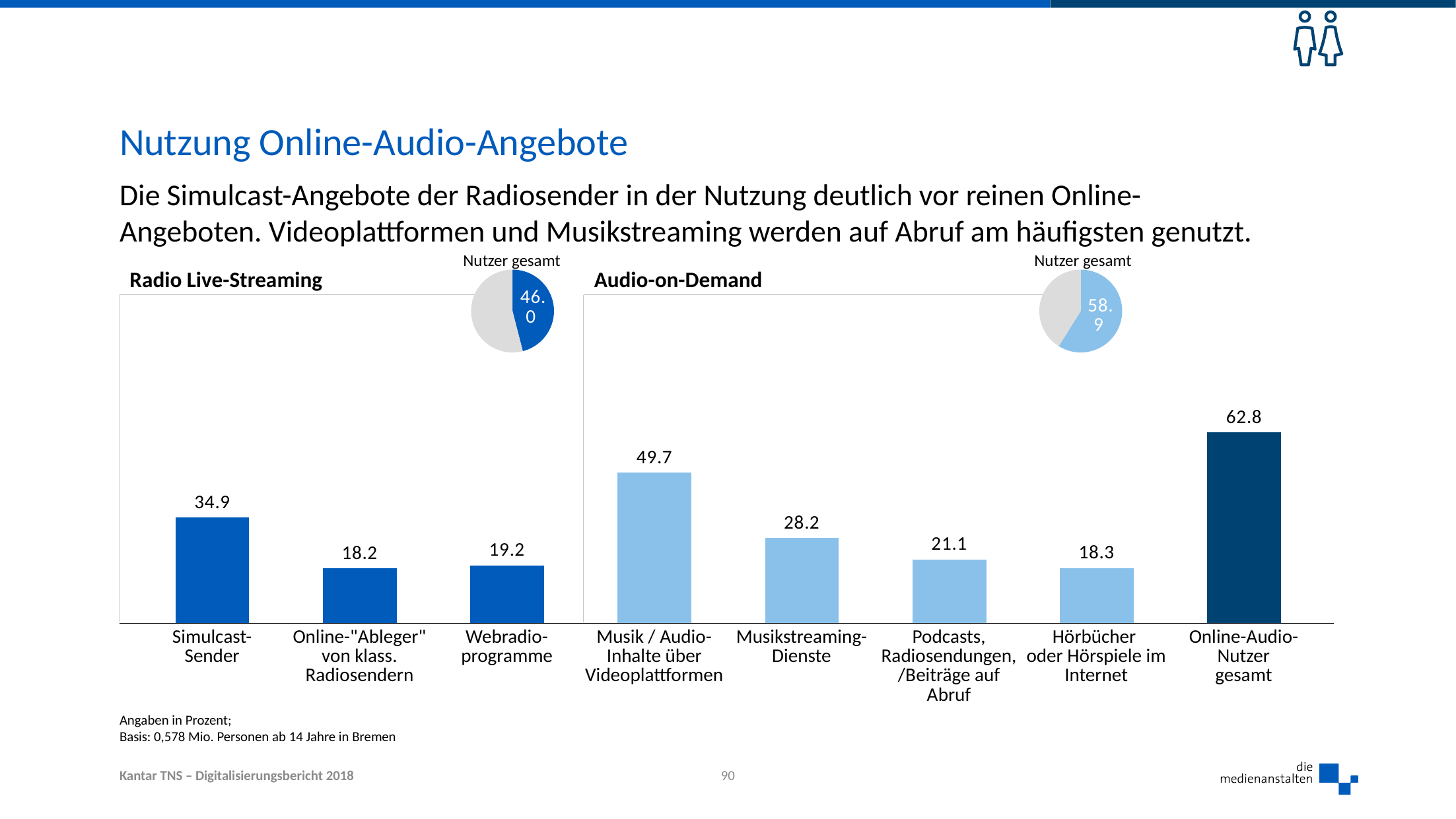
How many bars are in the Audio-on-Demand chart? 5 In the Radio Live-Streaming chart, what is the difference between Simulcast-Sender and Webradio-programme? 15.7 In the Audio-on-Demand chart, what is the value for Musikstreaming-Dienste? 28.2 In the Nutzer gesamt pie chart next to the Audio-on-Demand chart, what value is shown for the highlighted slice? 58.9 In the Audio-on-Demand chart, which category has the highest value? Online-Audio-Nutzer gesamt What kind of chart is the Radio Live-Streaming chart? bar chart In the Audio-on-Demand chart, what is the difference between Musik / Audio-Inhalte über Videoplattformen and Musikstreaming-Dienste? 21.5 In the Radio Live-Streaming chart, what is the value for Simulcast-Sender? 34.9 How many bars are in the Radio Live-Streaming chart? 3 In the Audio-on-Demand chart, which category has the lowest value? Hörbücher oder Hörspiele im Internet In the Radio Live-Streaming chart, which category has the lowest value? Online-"Ableger" von klass. Radiosendern In the Audio-on-Demand chart, which is larger: Podcasts, Radiosendungen/Beiträge auf Abruf or Hörbücher oder Hörspiele im Internet? Podcasts, Radiosendungen/Beiträge auf Abruf